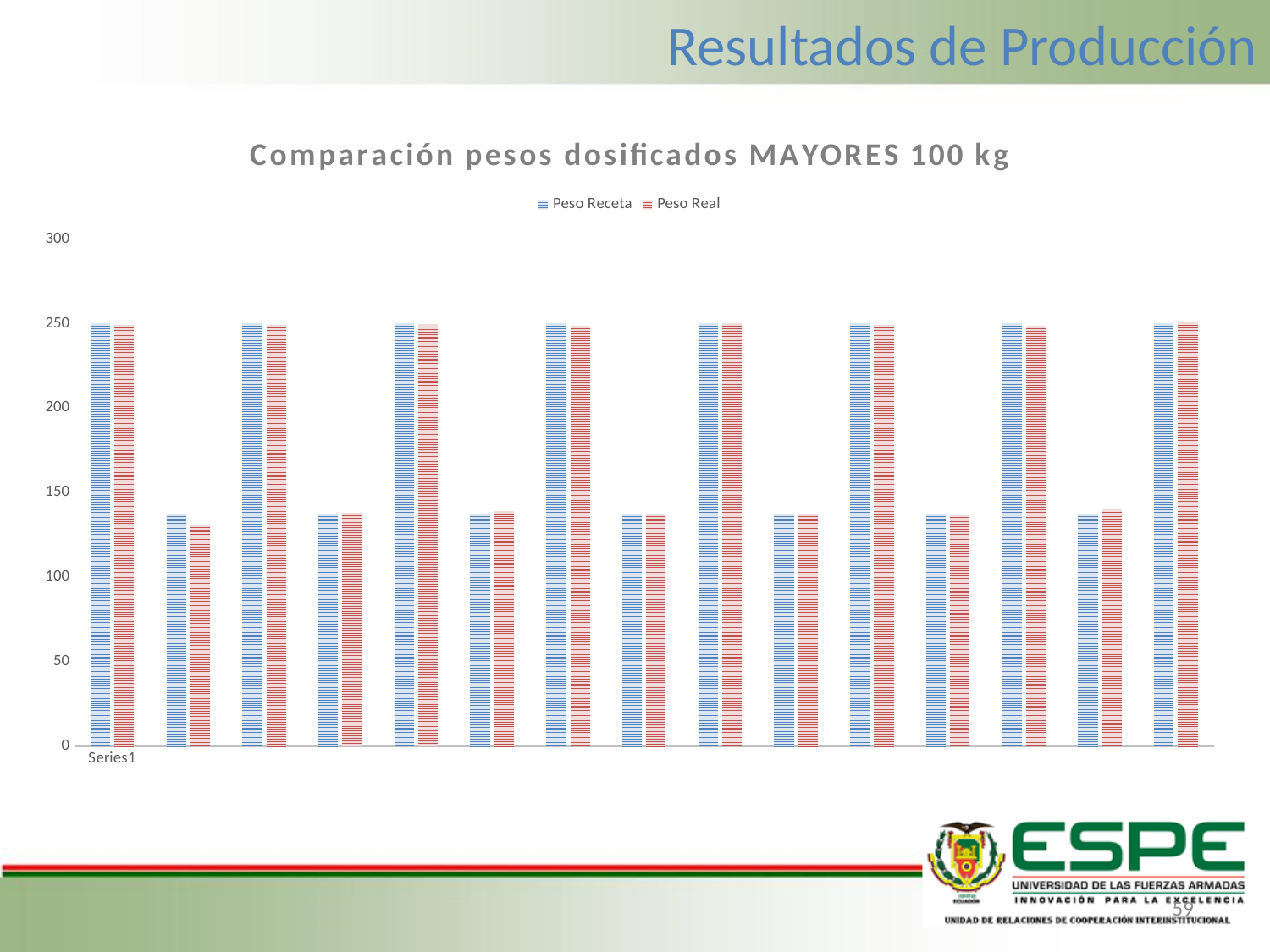
What is the highest value shown on the vertical axis? 300 Is the Peso Receta value for Series1 greater or less than 200? greater What kind of chart is shown on the slide? bar chart What are the two series named in the legend? Peso Receta and Peso Real Is the Peso Real value for the second pair of bars from the left greater or less than 150? less What is the title of the chart? Comparación pesos dosificados MAYORES 100 kg Is the Peso Real value for the rightmost pair of bars greater or less than 200? greater How many series does the legend list? 2 How many pairs of bars (categories) are plotted in the chart? 15